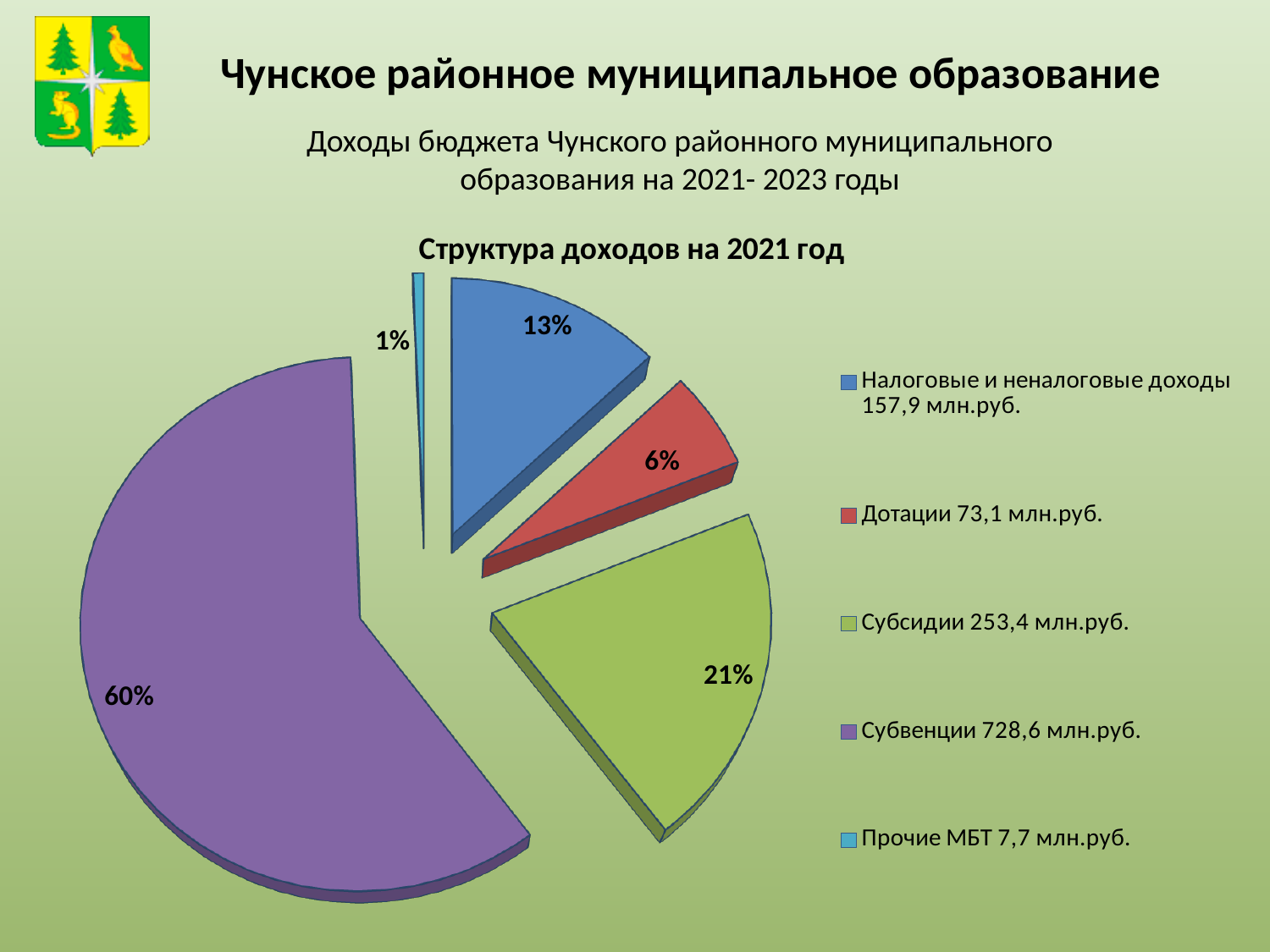
What share of the pie is labelled for Субвенции? 60% What share of the pie is labelled for Дотации? 6% What kind of chart is shown on the slide? Pie chart Which category has the smallest slice of the pie? Прочие МБТ Which category has the largest slice of the pie? Субвенции Which slice is larger: Дотации or Налоговые и неналоговые доходы? Налоговые и неналоговые доходы What share of the pie is labelled for Субсидии? 21% How many slices does the pie chart have? 5 According to the legend, what amount in млн.руб. is given for Субсидии? 253,4 млн.руб. What is the difference in percentage points between the Субвенции slice and the Субсидии slice? 39 What is the title of the chart? Структура доходов на 2021 год